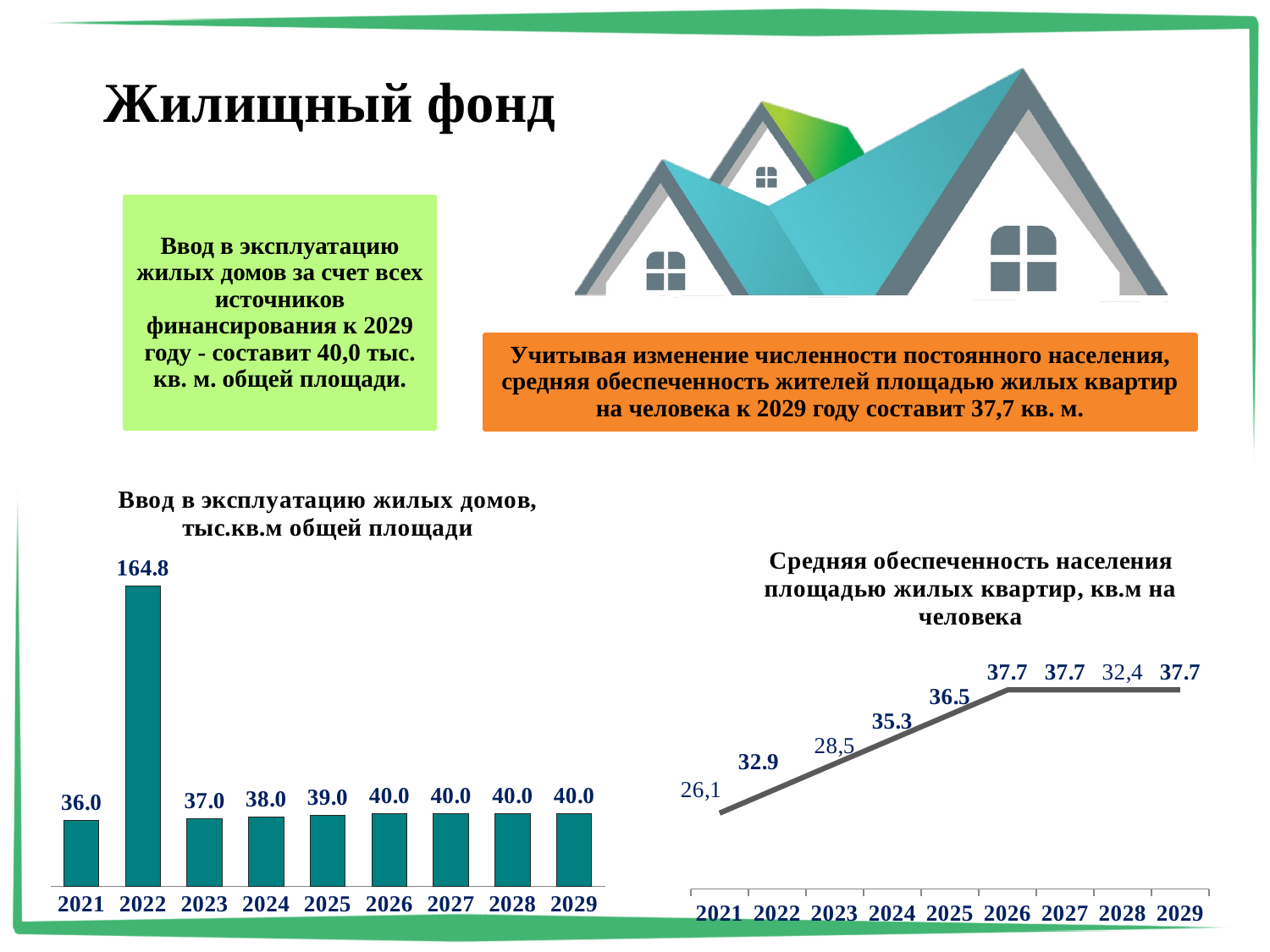
In the bar chart 'Ввод в эксплуатацию жилых домов', what is the difference between the values for 2022 and 2023? 127.8 In the bar chart 'Ввод в эксплуатацию жилых домов', what is the value for 2021? 36.0 What type of chart is the left chart 'Ввод в эксплуатацию жилых домов'? bar chart In the line chart 'Средняя обеспеченность населения площадью жилых квартир', is the value for 2024 larger or smaller than the value for 2022? larger In the line chart 'Средняя обеспеченность населения площадью жилых квартир', what is the value for 2029? 37.7 In the bar chart 'Ввод в эксплуатацию жилых домов', how many years are shown on the x axis? 9 In the line chart 'Средняя обеспеченность населения площадью жилых квартир', what is the value for 2022? 32.9 In the bar chart 'Ввод в эксплуатацию жилых домов', what is the value for 2022? 164.8 In the bar chart 'Ввод в эксплуатацию жилых домов', which year has the highest value? 2022 In the line chart 'Средняя обеспеченность населения площадью жилых квартир', what is the value for 2025? 36.5 In the bar chart 'Ввод в эксплуатацию жилых домов', which year has the lowest value? 2021 What type of chart is the right chart 'Средняя обеспеченность населения площадью жилых квартир'? line chart